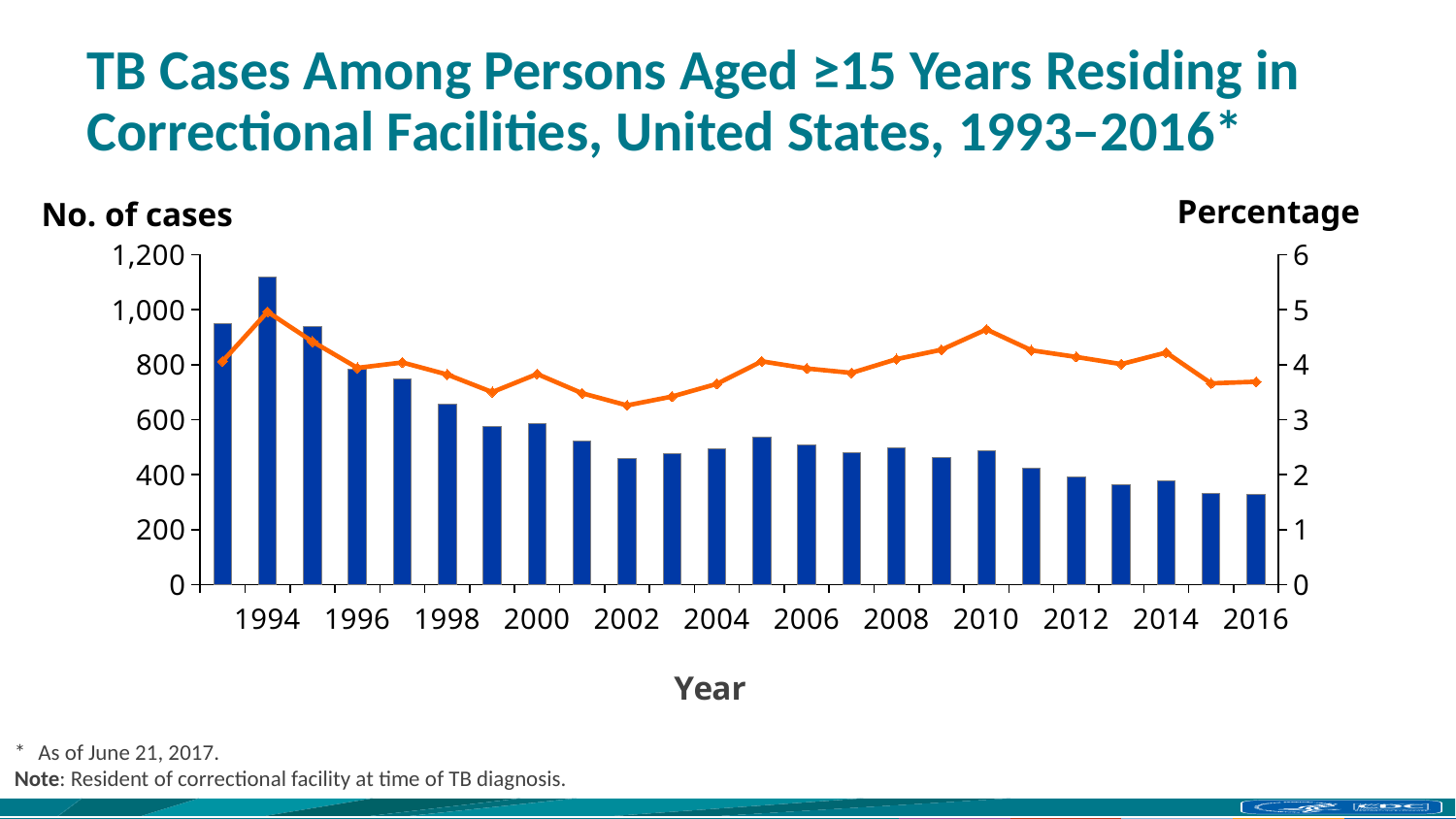
Which year has the highest percentage on the line series? 1994 Overall, do the number of cases rise or fall from 1993 to 2016? fall Is the number of cases in 2016 greater or less than 400? less Is the number of cases in 2002 greater or less than 600? less Which year has the highest number of TB cases (tallest bar)? 1994 What is the label of the right-hand vertical axis? Percentage How many years are plotted on the chart? 24 What kind of chart is shown on the slide? A combination bar and line chart Is the percentage for 2010 greater or less than 4? greater Which year has more TB cases, 1993 or 1994? 1994 Which year has the lowest percentage on the line series? 2002